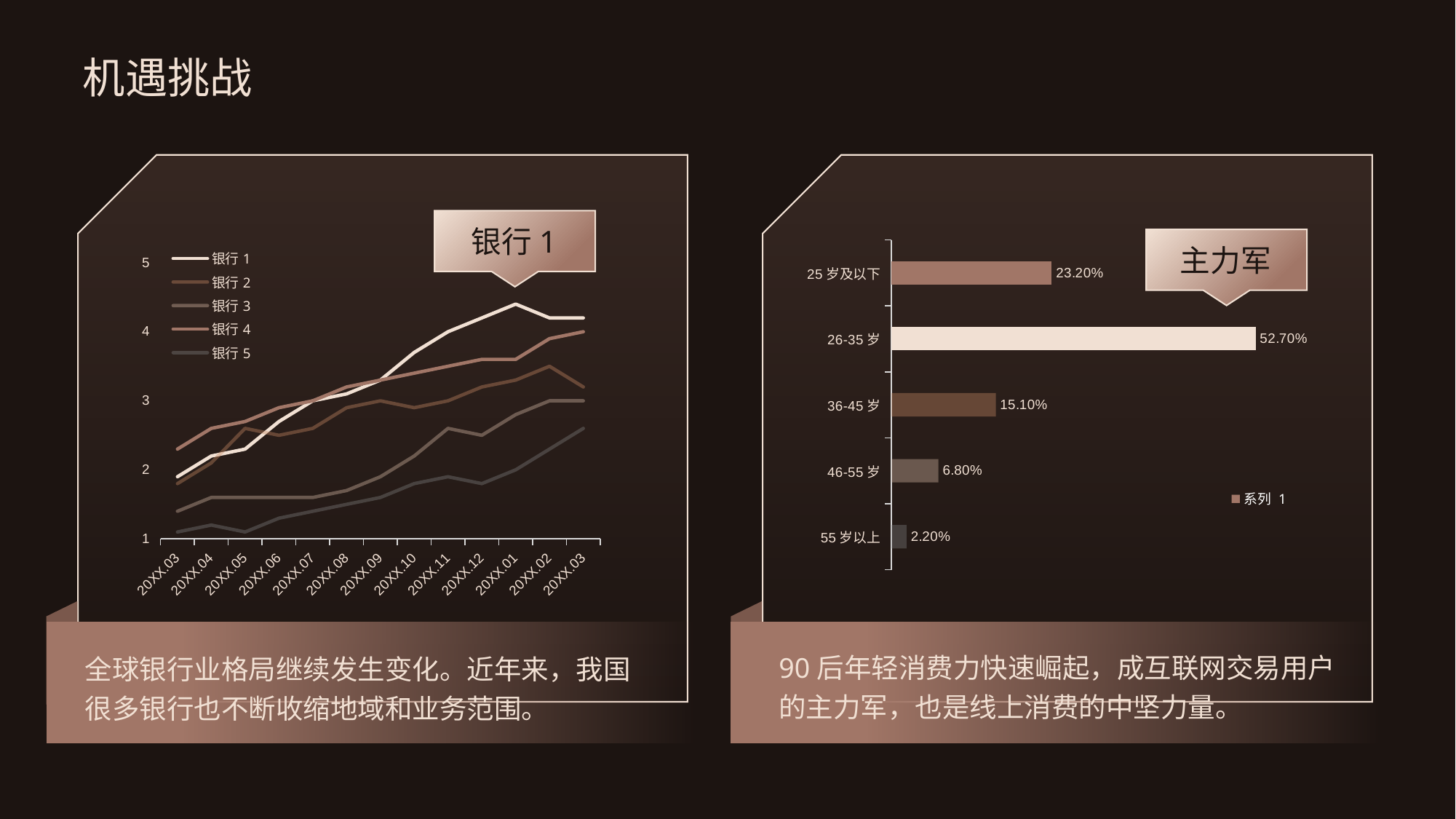
On the right chart, which age group has the lowest value? 55 岁以上 On the right chart, which is larger, the value for 36-45 岁 or 46-55 岁? 36-45 岁 On the left chart, how many series does the legend list? 5 On the right chart, what is the value for 26-35 岁? 52.70% What kind of chart is the left chart? line chart On the right chart, how many age groups are shown? 5 On the left chart, does the line for 银行 1 generally rise or fall from 20XX.03 to 20XX.01? rise On the right chart, what is the difference between the values for 26-35 岁 and 25 岁及以下? 29.50% On the right chart, what is the value for 46-55 岁? 6.80% On the left chart, is the value for 银行 1 at 20XX.01 greater or less than 4? greater On the right chart, which age group has the highest value? 26-35 岁 What kind of chart is the right chart? bar chart